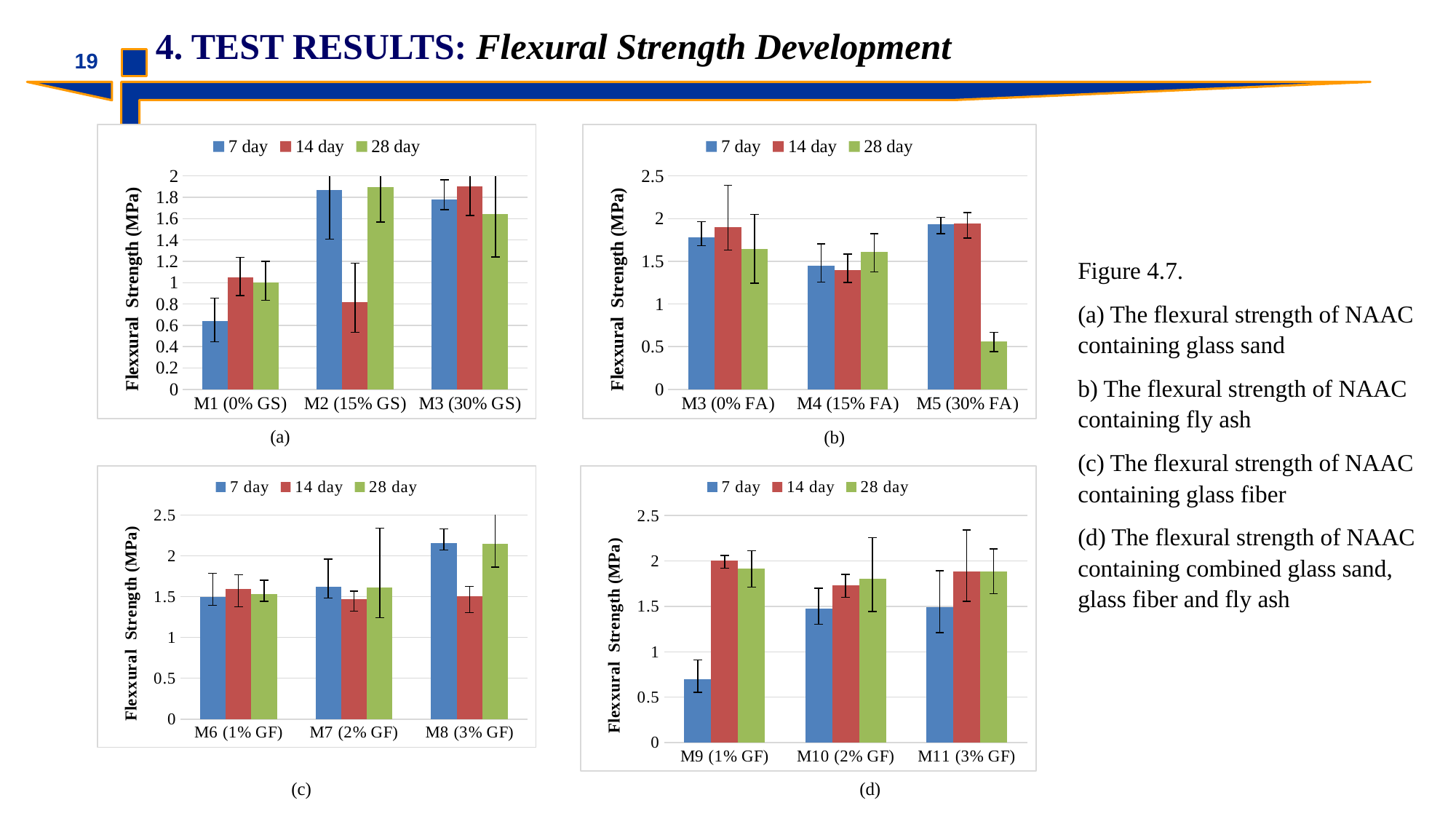
In chart (c), which category has the highest 7 day value? M8 (3% GF) In chart (d), what is the label on the vertical axis? Flexxural Strength (MPa) In chart (a), what kind of chart is shown? bar chart In chart (a), how many mix categories are shown on the x axis? 3 In chart (c), is the 7 day value for M8 (3% GF) greater or less than 2? greater In chart (b), is the 28 day value for M5 (30% FA) greater or less than 1? less In chart (b), which category has the lowest 28 day value? M5 (30% FA) In chart (a), is the 7 day value for M1 (0% GS) greater or less than 0.8? less In chart (d), which category has the lowest 7 day value? M9 (1% GF) In chart (a), for M2 (15% GS), which is larger: the 7 day value or the 14 day value? 7 day In chart (a), how many series does the legend list? 3